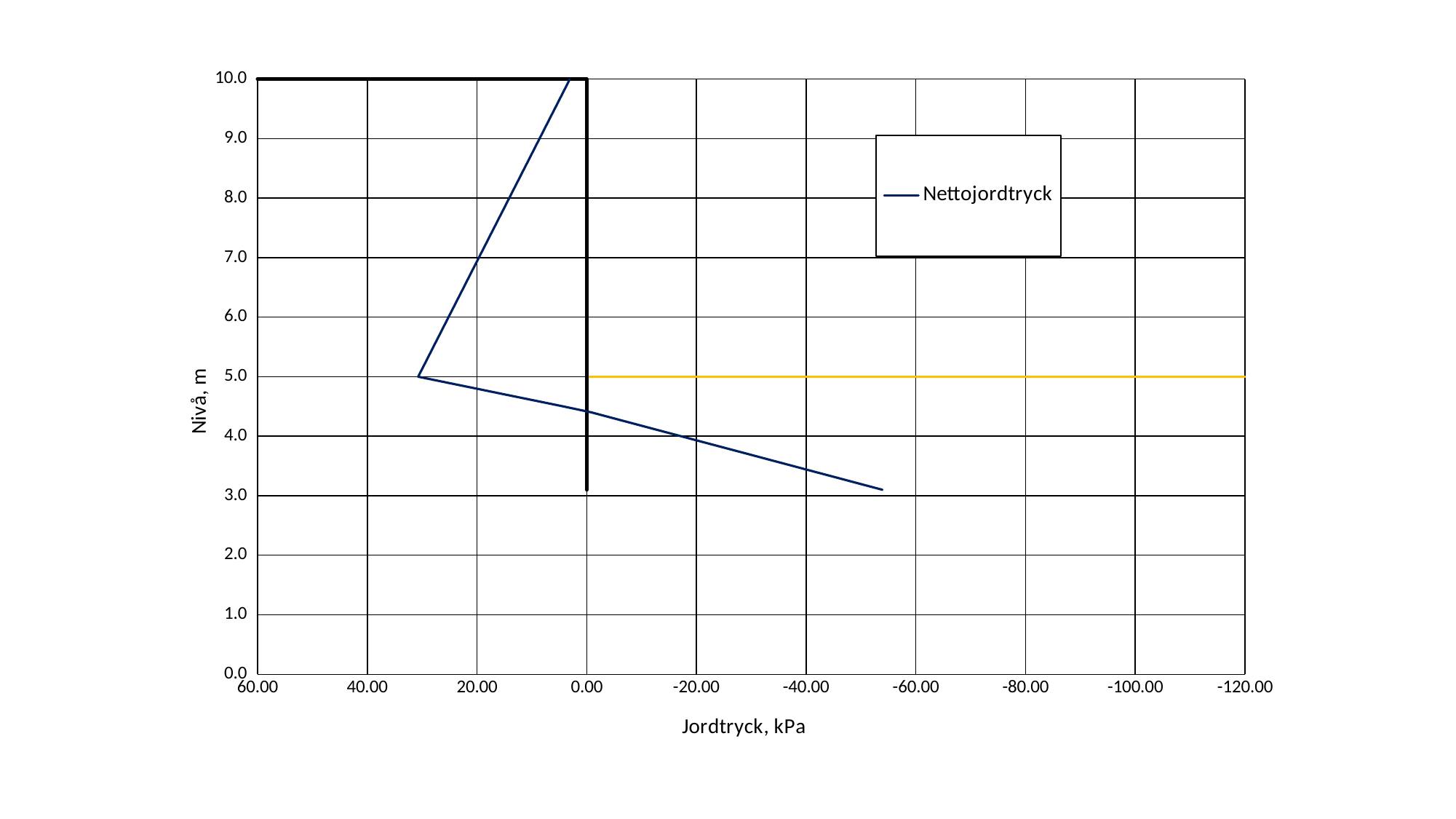
Does the Nettojordtryck value rise or fall as the level goes down from 5.0 m to 3.0 m? fall What is the name of the series shown in the legend? Nettojordtryck Is the Nettojordtryck value at level 4.0 m greater or less than 0.00 kPa? less Is the Nettojordtryck value at the lowest plotted level (about 3.0 m) greater or less than -40.00 kPa? less What is the title of the horizontal axis? Jordtryck, kPa Is the Nettojordtryck value at level 10.0 m greater or less than 20.00 kPa? less How many series does the legend list? 1 Does the Nettojordtryck value rise or fall as the level goes down from 10.0 m to 5.0 m? rise What kind of chart is shown on the slide? line chart